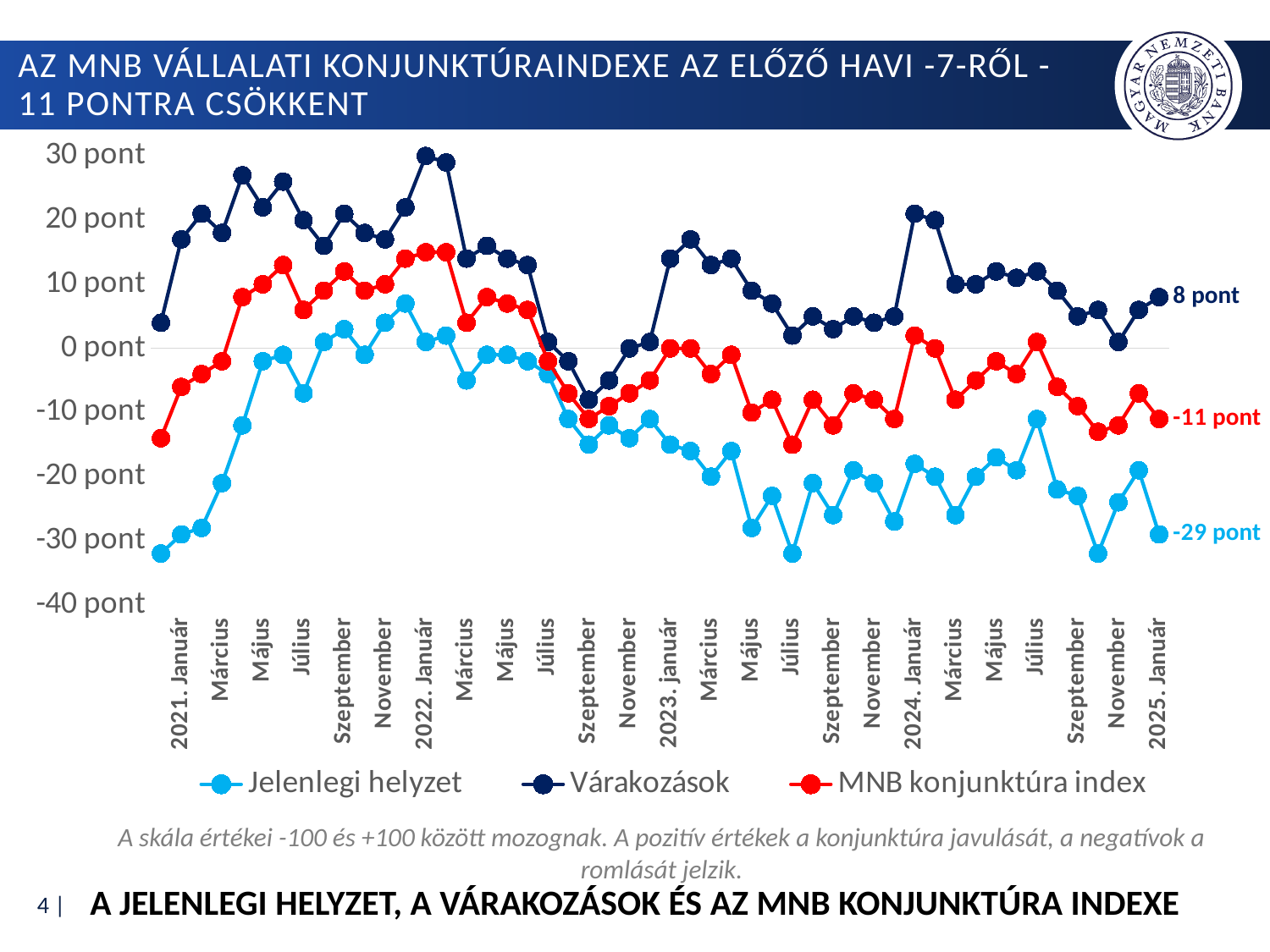
What is the value of the MNB konjunktúra index in 2025. január? -11 pont Which series has the lowest value in 2025. január? Jelenlegi helyzet How many series does the legend list? 3 Is the value of Jelenlegi helyzet in 2021. január greater or less than -20 pont? less Does the Várakozások series rise or fall between 2022. január and 2022. szeptember? fall In 2025. január, which is larger: Várakozások or Jelenlegi helyzet? Várakozások What is the difference between Várakozások and the MNB konjunktúra index in 2025. január? 19 pont Is the value of Várakozások in 2022. január greater or less than 20 pont? greater What kind of chart is shown on the slide? line chart What is the value of Jelenlegi helyzet in 2025. január? -29 pont What is the value of Várakozások in 2025. január? 8 pont What colour is the MNB konjunktúra index line? red